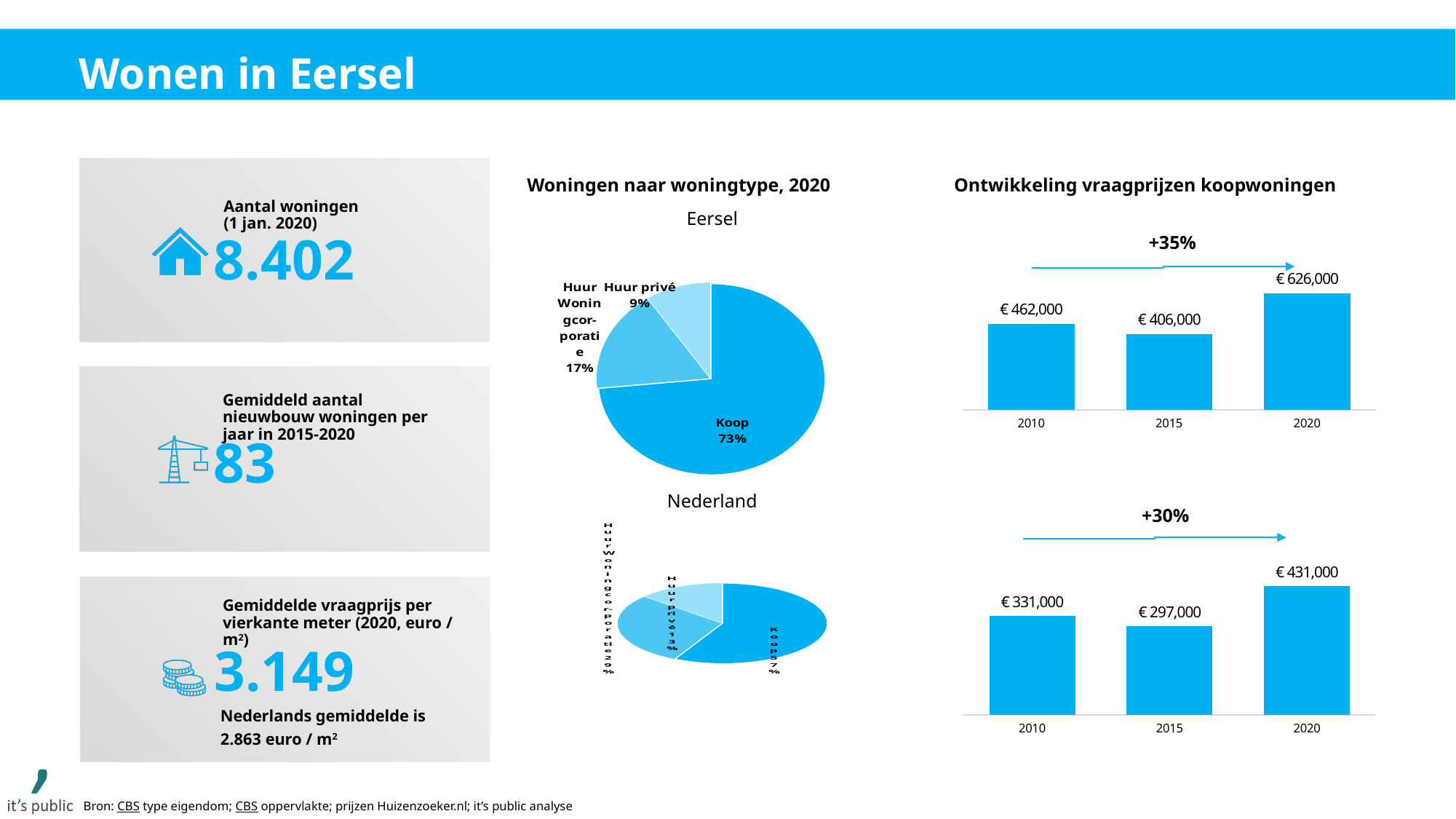
What type of chart is used for 'Ontwikkeling vraagprijzen koopwoningen'? Bar chart In the Eersel pie chart, what share is Huur Woningcorporatie? 17% In the upper bar chart under 'Ontwikkeling vraagprijzen koopwoningen', what is the difference between the 2020 and 2010 values? € 164,000 How many slices does the Eersel pie chart have? 3 In the Eersel pie chart, what share is Huur privé? 9% In the lower bar chart under 'Ontwikkeling vraagprijzen koopwoningen', which year has the lowest value? 2015 In the Eersel pie chart, which category has the largest slice? Koop In the upper bar chart under 'Ontwikkeling vraagprijzen koopwoningen', what is the value for 2020? € 626,000 In the Eersel pie chart, which category has the smallest slice? Huur privé In the lower bar chart under 'Ontwikkeling vraagprijzen koopwoningen', what is the value for 2010? € 331,000 In the upper bar chart under 'Ontwikkeling vraagprijzen koopwoningen', what is the value for 2015? € 406,000 In the Eersel pie chart under 'Woningen naar woningtype, 2020', what share is Koop? 73%